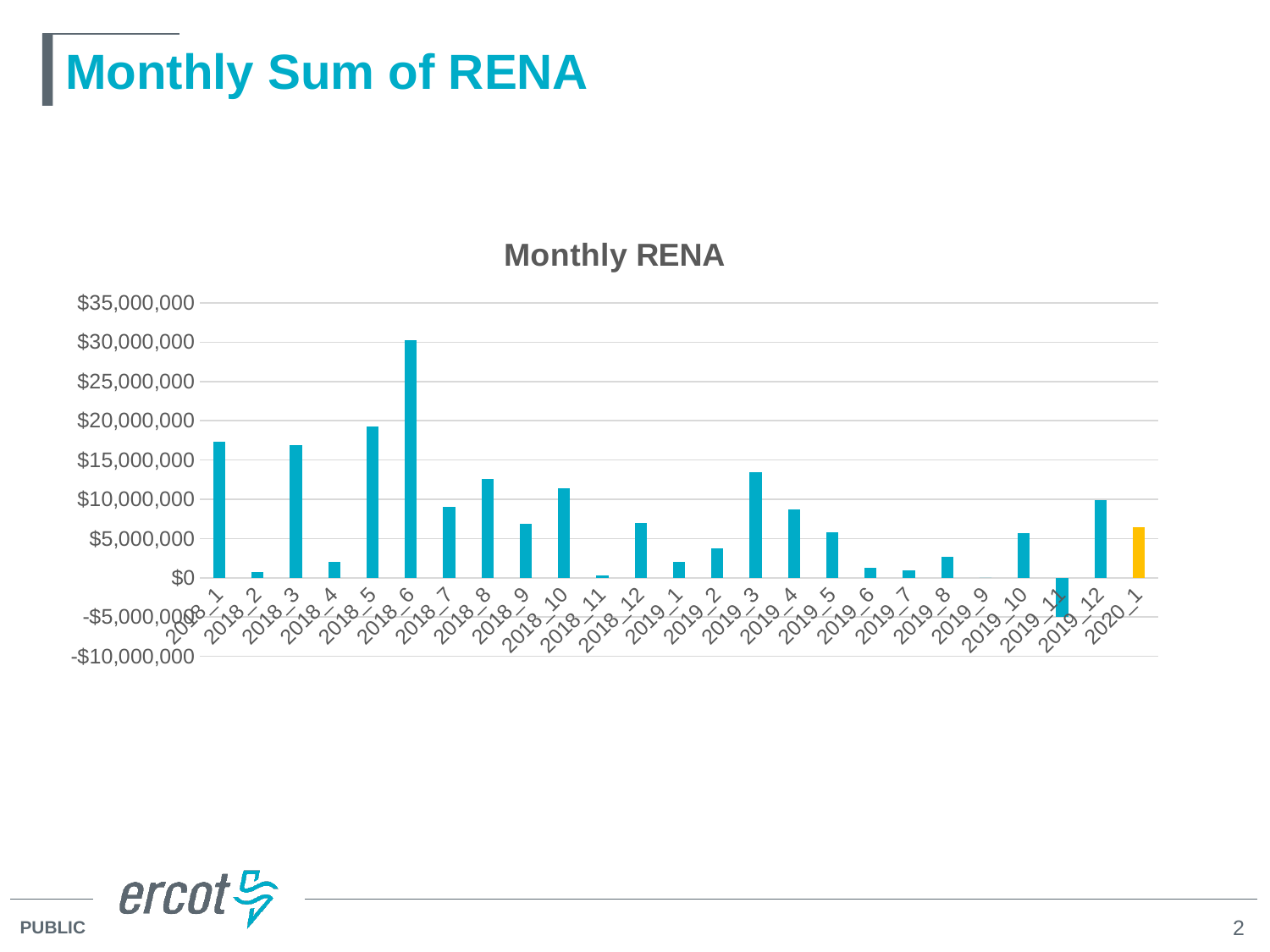
How many months are plotted on the x axis? 25 Which is larger, the value for 2019_3 or the value for 2019_2? 2019_3 Is the value for 2018_6 greater or less than $25,000,000? greater Is the value for 2019_11 greater or less than $0? less Which is larger, the value for 2018_5 or the value for 2018_7? 2018_5 Is the value for 2018_1 greater or less than $15,000,000? greater What is the title of the chart? Monthly RENA Which month has the highest Monthly RENA value? 2018_6 Which month has the lowest Monthly RENA value? 2019_11 Which bar is shown in a different colour (yellow) from the rest? 2020_1 What kind of chart is shown on the slide? Bar chart